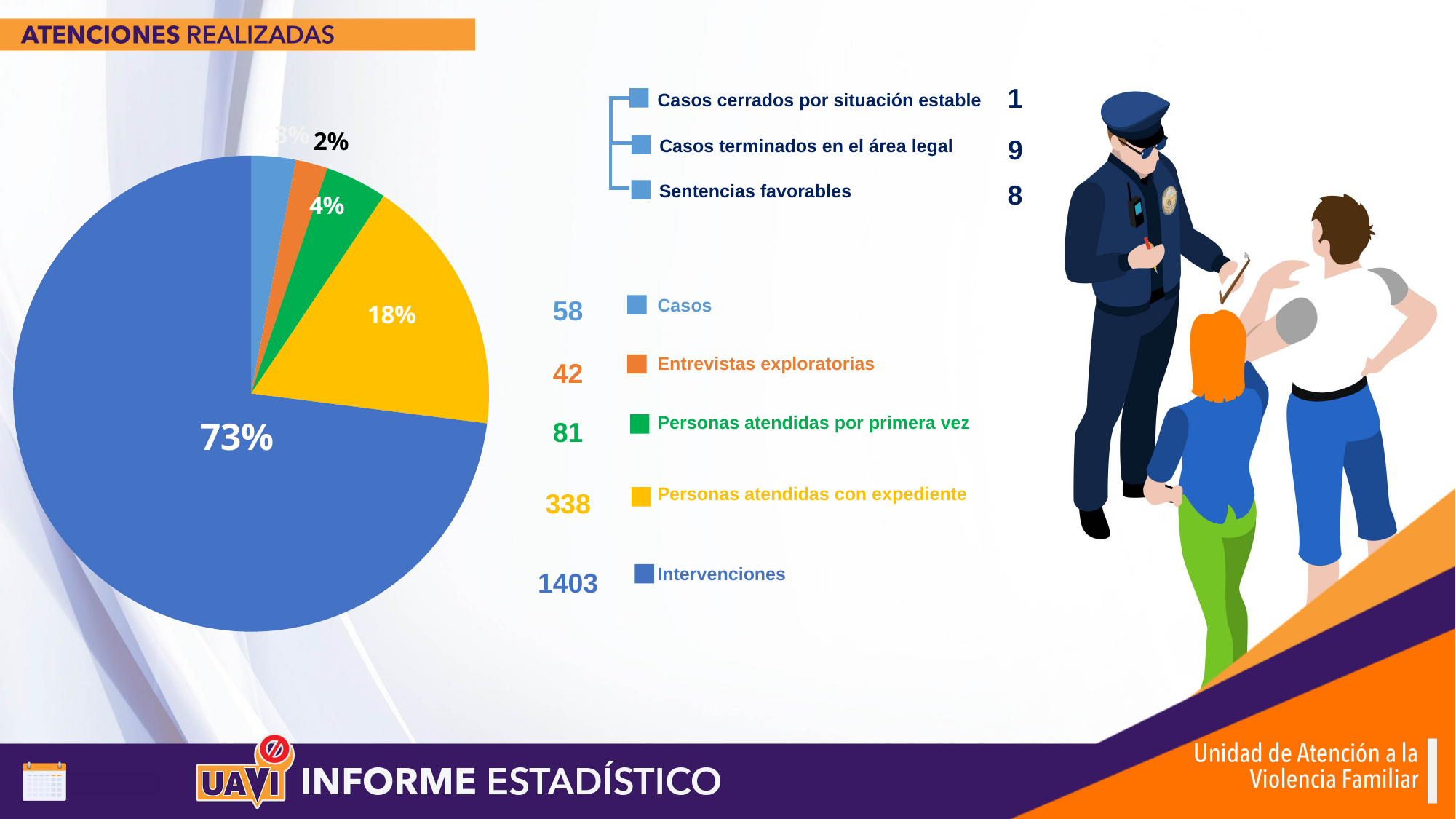
How many categories does the pie chart legend list? 5 What value is shown next to Intervenciones in the legend? 1403 What percentage of the pie does the Personas atendidas con expediente slice represent? 18% What colour is the Intervenciones slice of the pie? blue Which category has the largest slice of the pie? Intervenciones Which category has the smallest slice of the pie? Entrevistas exploratorias Which is larger, the slice for Personas atendidas con expediente or the slice for Personas atendidas por primera vez? Personas atendidas con expediente What percentage of the pie does the Entrevistas exploratorias slice represent? 2% What percentage of the pie does the Intervenciones slice represent? 73% What kind of chart is shown on the slide? pie chart What value is shown next to Personas atendidas con expediente in the legend? 338